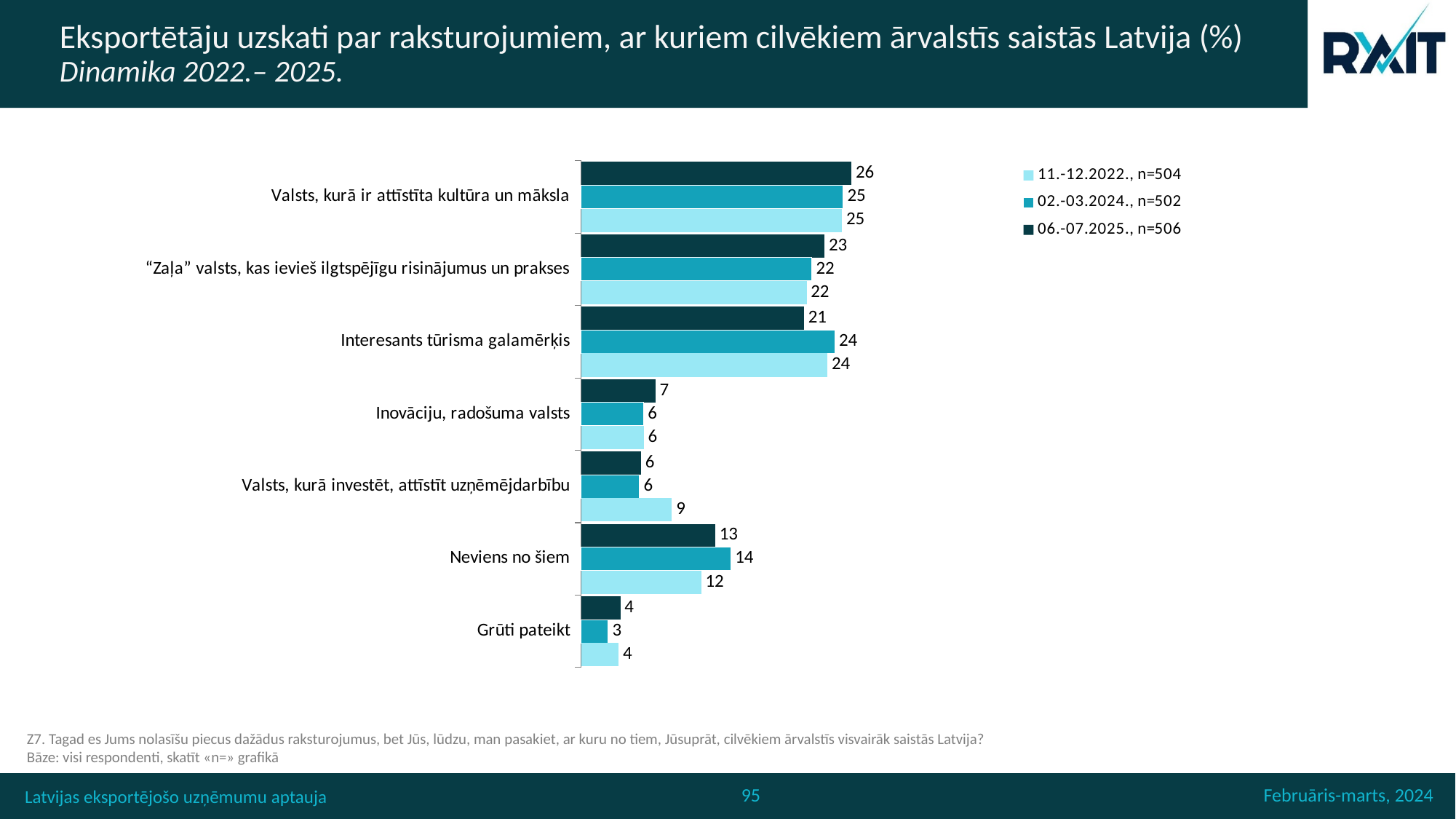
What is the value for "Interesants tūrisma galamērķis" in the 02.-03.2024., n=502 series? 24 How many series does the legend list? 3 What is the difference between the 06.-07.2025. and 11.-12.2022. values for "Interesants tūrisma galamērķis"? 3 For "Neviens no šiem", which is larger: the 02.-03.2024. value or the 11.-12.2022. value? 02.-03.2024. What is the value for "Valsts, kurā investēt, attīstīt uzņēmējdarbību" in the 11.-12.2022., n=504 series? 9 Which category has the highest value in the 06.-07.2025., n=506 series? Valsts, kurā ir attīstīta kultūra un māksla How many categories are shown on the chart? 7 What kind of chart is shown on the slide? Bar chart What is the sample size (n) shown in the legend for the 06.-07.2025. series? n=506 What is the value for "Valsts, kurā ir attīstīta kultūra un māksla" in the 06.-07.2025., n=506 series? 26 What is the value for "Neviens no šiem" in the 02.-03.2024., n=502 series? 14 Which category has the lowest value in the 02.-03.2024., n=502 series? Grūti pateikt